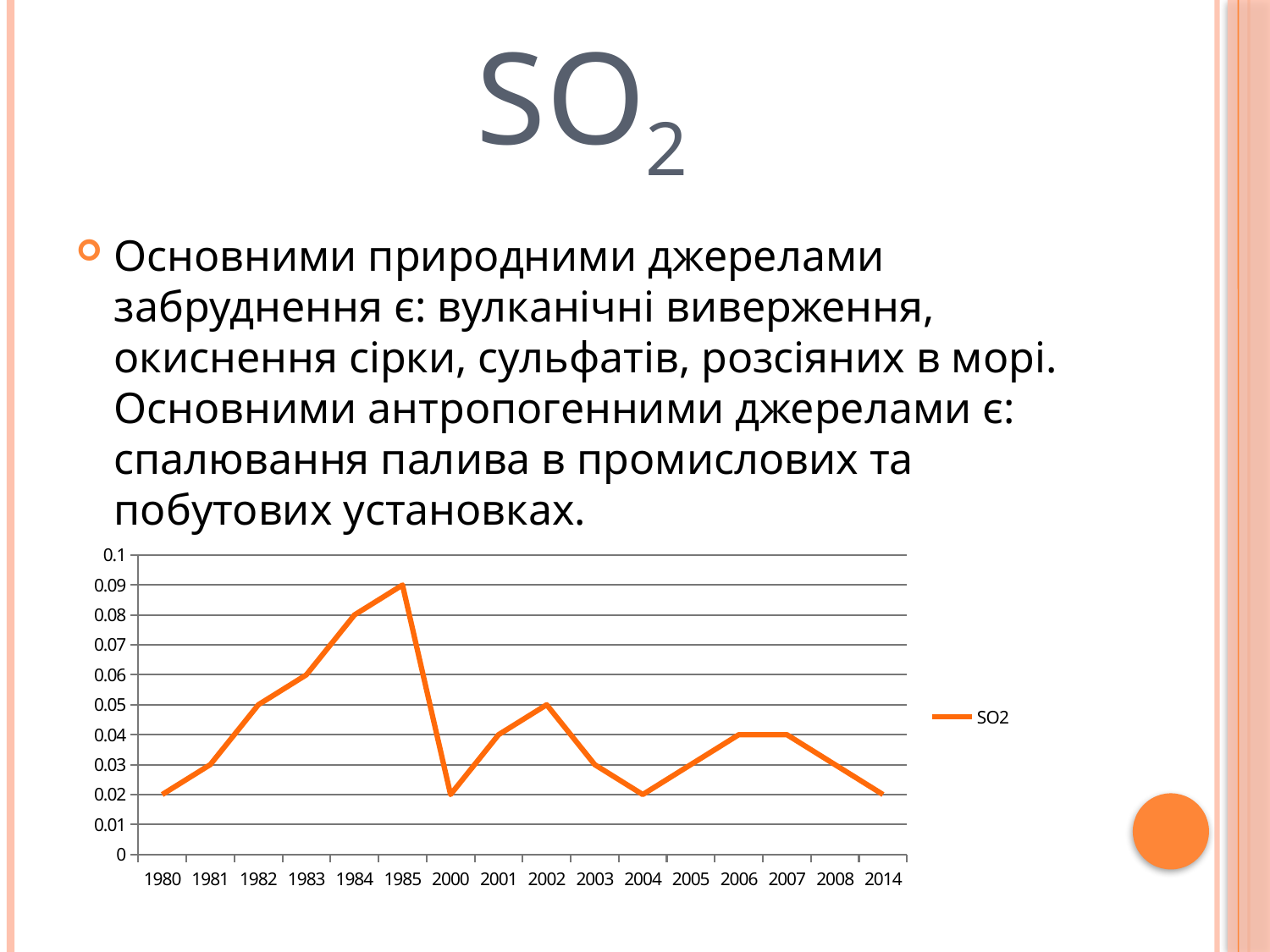
What is the SO2 value for 1984? 0.08 Does the SO2 value rise or fall from 1980 to 1985? rise Which is larger, the SO2 value for 1983 or for 2003? 1983 What is the name of the series shown in the legend? SO2 Is the SO2 value for 2002 greater or less than 0.04? greater What is the SO2 value for 1980? 0.02 Which year has the highest SO2 value? 1985 What is the SO2 value for 1985? 0.09 How many years are shown on the x axis? 16 How many series does the legend list? 1 Is the SO2 value for 2004 greater or less than 0.05? less What kind of chart is shown on the slide? line chart